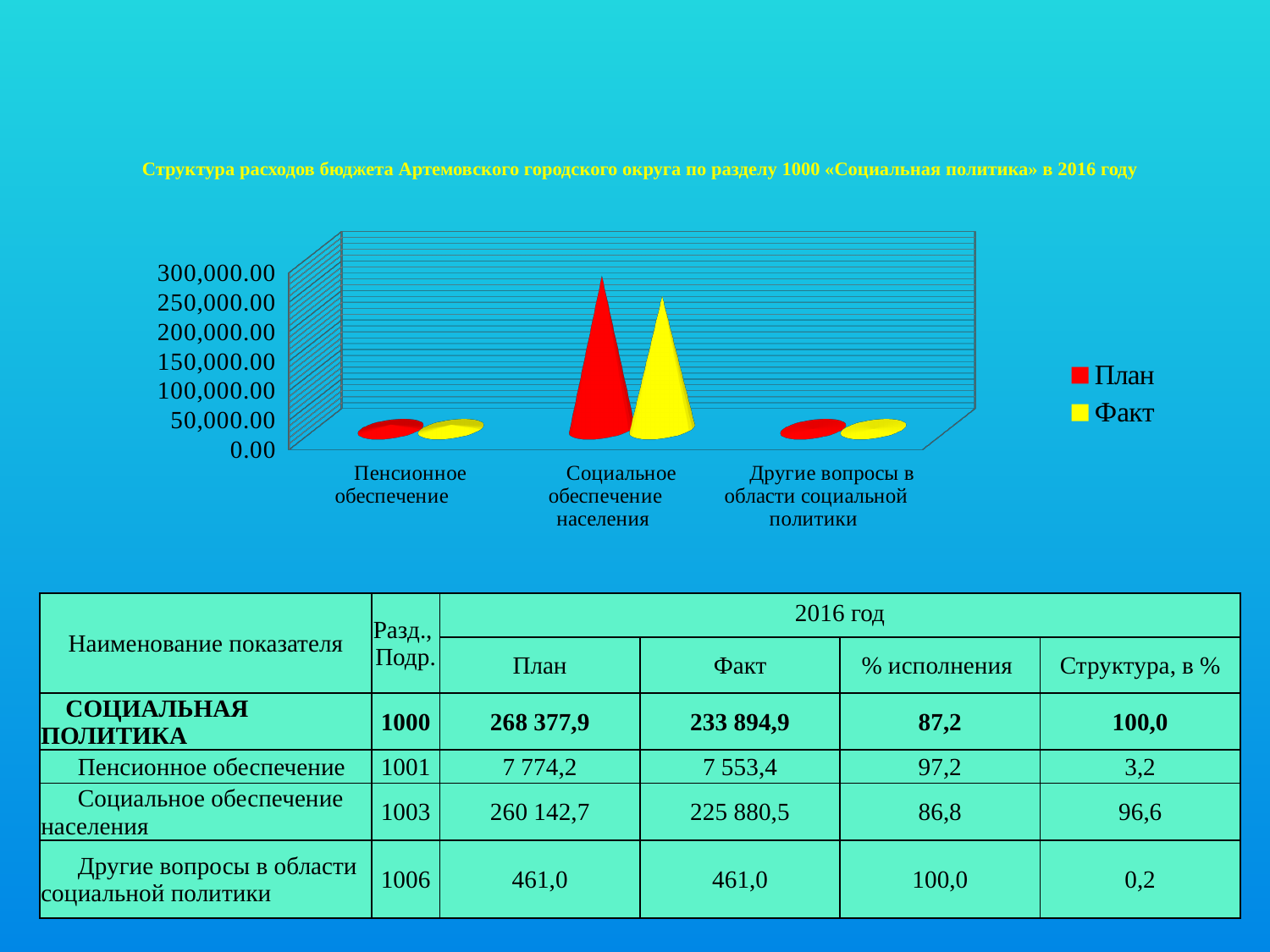
Which category has the highest План value in the chart? Социальное обеспечение населения What colour represents the Факт series in the chart legend? yellow What kind of chart is shown on the slide? bar chart Is the План value for Пенсионное обеспечение greater or less than 50,000.00? less Is the План value for Социальное обеспечение населения greater or less than 250,000.00? greater Using the values in the table, what is the difference between План and Факт for Пенсионное обеспечение? 220,8 According to the table on the slide, what is the Факт value for Социальное обеспечение населения? 225 880,5 Is the Факт value for Социальное обеспечение населения greater or less than 250,000.00? less For Социальное обеспечение населения, which is larger: План or Факт? План How many categories are shown along the x axis of the chart? 3 How many series does the chart legend list? 2 According to the table on the slide, what is the План value for Пенсионное обеспечение? 7 774,2